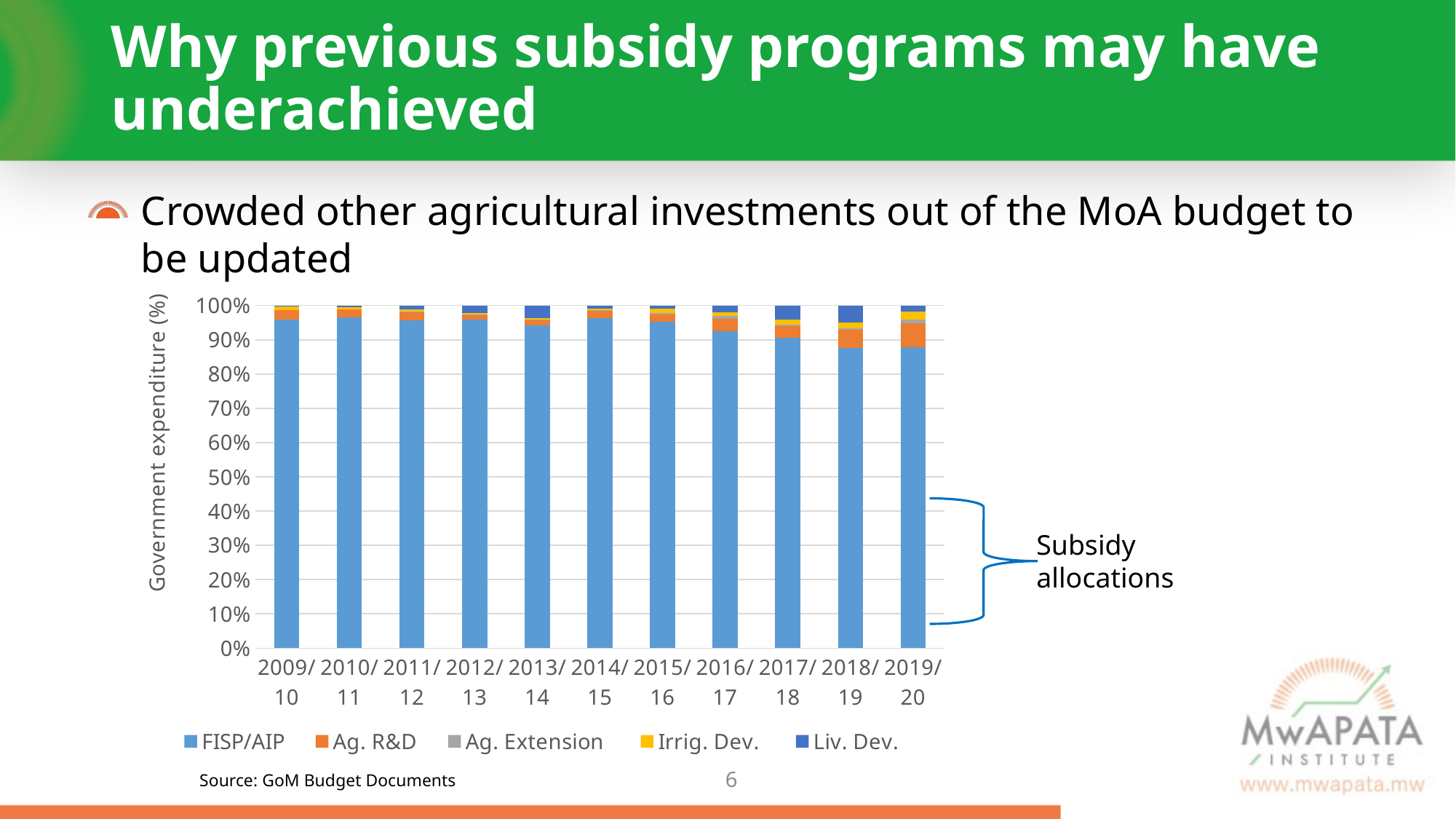
What is the total of the stacked bar for 2013/14? 100% What is the label on the chart's vertical axis? Government expenditure (%) Is the FISP/AIP share of government expenditure in 2009/10 greater or less than 90%? greater How many series does the chart's legend list? 5 Does the FISP/AIP share of government expenditure generally rise or fall from 2009/10 to 2019/20? fall What kind of chart is shown on the slide? Stacked bar chart How many fiscal years are shown on the x axis of the chart? 11 Which is larger: the FISP/AIP share in 2009/10 or in 2018/19? 2009/10 Is the FISP/AIP share of government expenditure in 2018/19 greater or less than 90%? less Is the FISP/AIP share of government expenditure in 2016/17 greater or less than 80%? greater Which series occupies the largest portion of every bar in the chart? FISP/AIP Which series is listed first in the chart's legend? FISP/AIP